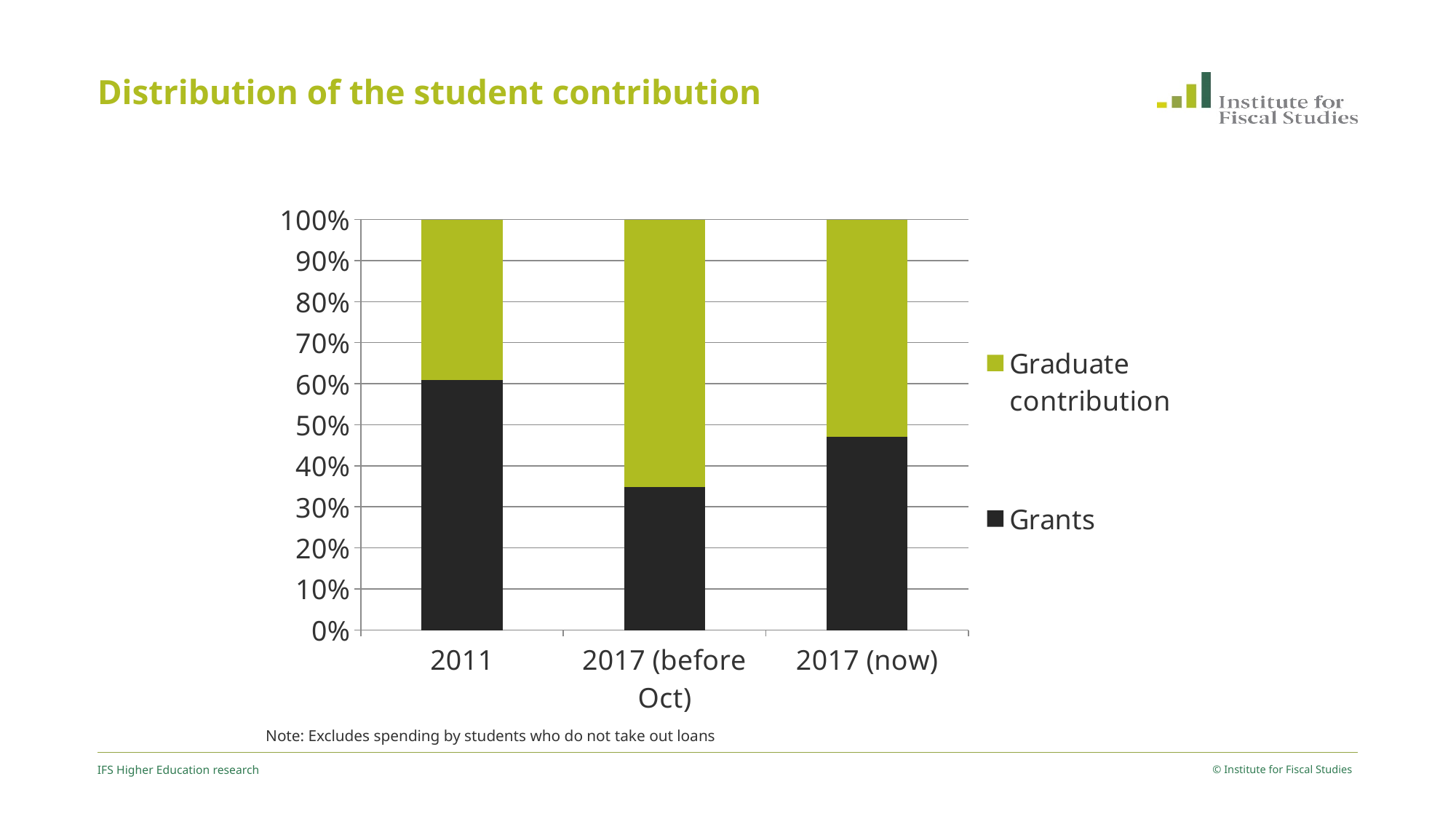
Which category has the highest Graduate contribution share? 2017 (before Oct) Which category has the highest Grants share? 2011 What kind of chart is shown on the slide? stacked bar chart How many series does the legend list? 2 Which category has the lowest Grants share? 2017 (before Oct) Is the Grants share for 2011 greater or less than 50%? greater Is the Grants share for 2017 (now) greater or less than 40%? greater Is the Grants share for 2017 (before Oct) greater or less than 40%? less Which series is shown in green? Graduate contribution How many categories are shown on the x axis? 3 Which is larger, the Grants share for 2011 or for 2017 (now)? 2011 What is the title of the chart? Distribution of the student contribution